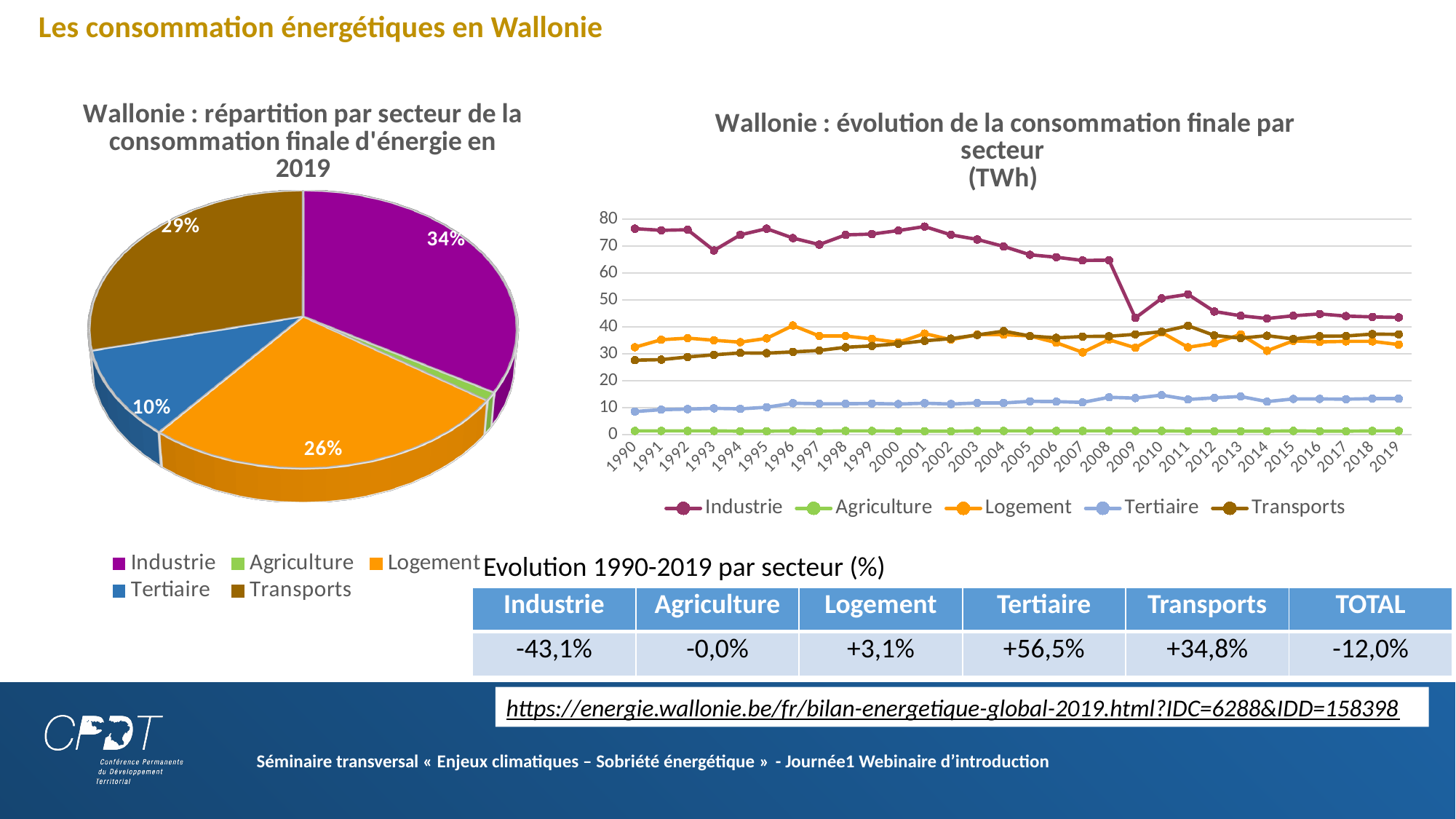
What kind of chart is the chart on the right, 'Wallonie : évolution de la consommation finale par secteur (TWh)'? Line chart In the pie chart on the left, which sector has the smallest share? Agriculture How many series does the legend of the line chart on the right list? 5 In the pie chart on the left, what share does Tertiaire have? 10% In the line chart on the right, which series has the lowest values throughout the period? Agriculture In the pie chart on the left, what is the difference in percentage points between the Industrie share and the Logement share? 8 percentage points In the pie chart on the left, which sector has the largest share? Industrie In the pie chart on the left, what share does Transports have? 29% In the pie chart on the left, what share of final energy consumption in 2019 does Industrie have? 34% In the pie chart on the left, which is larger: the Transports share or the Logement share? Transports In the line chart on the right, does the Industrie series rise or fall overall from 1990 to 2019? Fall In the line chart on the right, is the value for Industrie in 1990 greater or less than 70? greater